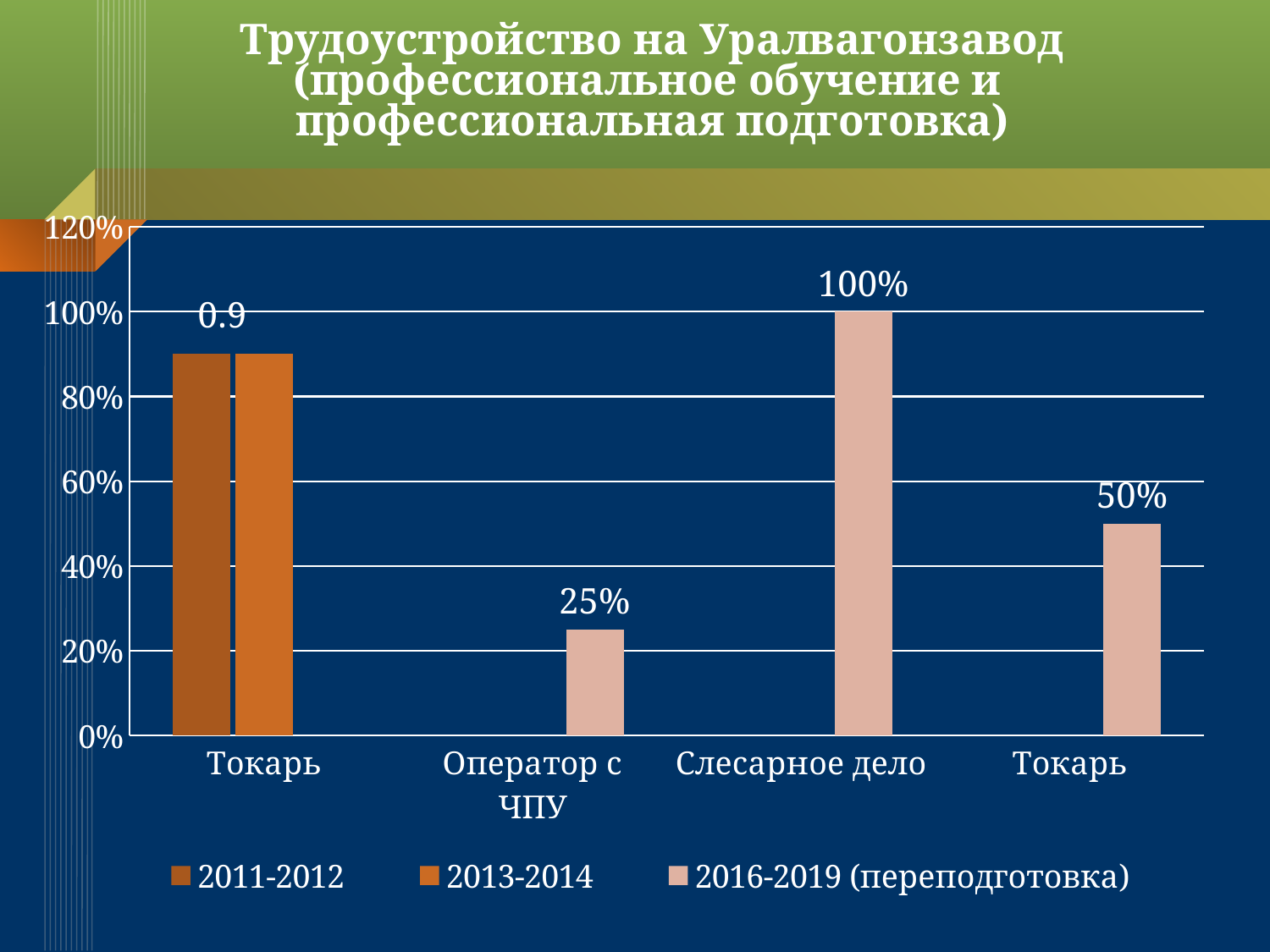
Which category has the highest value in the 2016-2019 (переподготовка) series? Слесарное дело What kind of chart is shown on the slide? bar chart Is the 2013-2014 bar for the first Токарь category greater or less than 80%? greater What is the value for Слесарное дело in the 2016-2019 (переподготовка) series? 100% In the 2016-2019 (переподготовка) series, what is the difference between the values for Слесарное дело and Оператор с ЧПУ? 75% What is the value for Оператор с ЧПУ in the 2016-2019 (переподготовка) series? 25% How many categories are shown along the x axis? 4 What is the value for the rightmost Токарь category in the 2016-2019 (переподготовка) series? 50% Which category has the lowest value in the 2016-2019 (переподготовка) series? Оператор с ЧПУ How many series does the legend list? 3 What data label is printed above the 2011-2012 bar for the first Токарь category? 0.9 What is the third entry in the legend? 2016-2019 (переподготовка)